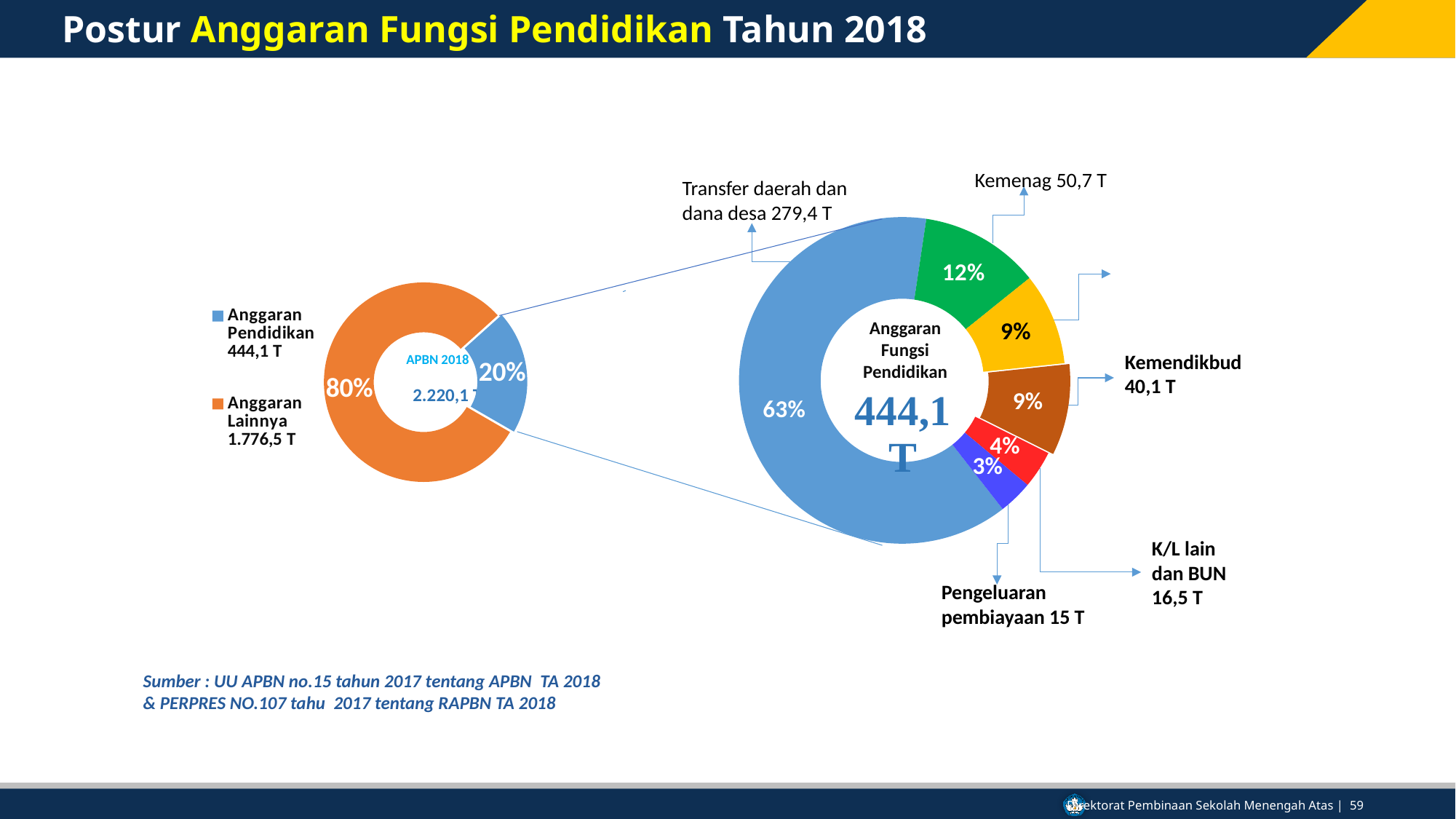
In the left donut chart, which is larger, Anggaran Pendidikan or Anggaran Lainnya? Anggaran Lainnya In the left donut chart (APBN 2018), what is the value given for Anggaran Lainnya? 1.776,5 T In the right donut chart (Anggaran Fungsi Pendidikan), what share is labelled for Transfer daerah dan dana desa? 63% In the right donut chart (Anggaran Fungsi Pendidikan), which component has the smallest share? Pengeluaran pembiayaan In the left donut chart (APBN 2018), what share is labelled for Anggaran Pendidikan? 20% In the right donut chart (Anggaran Fungsi Pendidikan), which component has the largest share? Transfer daerah dan dana desa In the left donut chart, what total is shown in the centre for APBN 2018? 2.220,1 T In the right donut chart (Anggaran Fungsi Pendidikan), what is the value given for Kemenag? 50,7 T In the right donut chart (Anggaran Fungsi Pendidikan), how many slices are there? 6 In the right donut chart, what is the difference between the Kemenag value and the Kemendikbud value? 10,6 T In the right donut chart (Anggaran Fungsi Pendidikan), what is the value given for Kemendikbud? 40,1 T What kind of chart is used on this slide? Donut (pie) chart